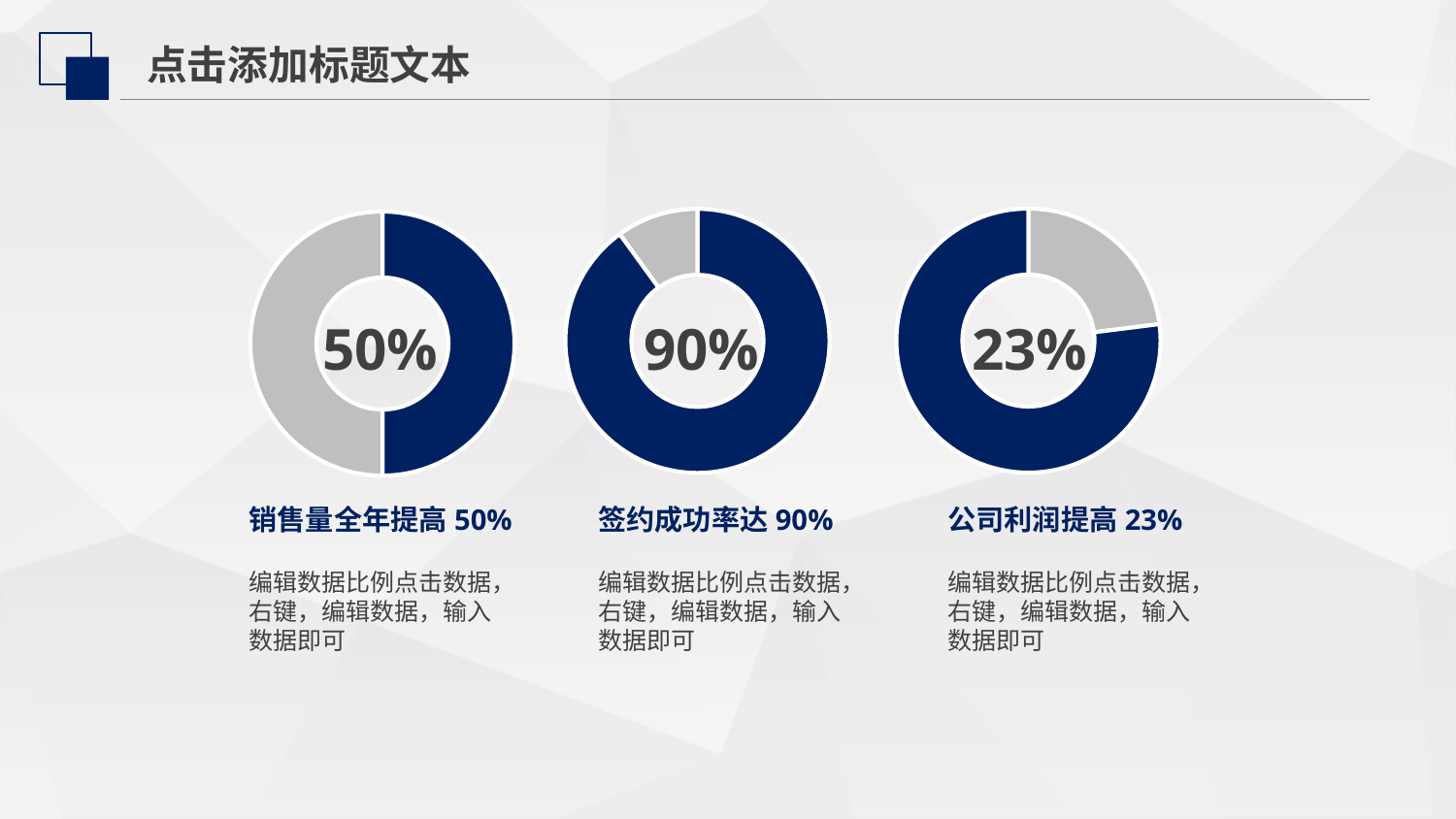
What percentage does the caption under the left donut chart say sales volume increased by over the year? 50% What colour is the filled (highlighted) portion of each donut chart? dark blue What kind of chart is used to show the 90% value? donut chart What value is shown in the center of the middle donut chart? 90% What value is shown in the center of the left donut chart? 50% Which of the three donut charts shows the lowest percentage? the right chart (23%) What is the difference between the percentage in the middle donut chart and the percentage in the right donut chart? 67% What value is shown in the center of the right donut chart? 23% How many donut charts are on the slide? 3 Is the percentage in the left donut chart larger or smaller than the percentage in the middle donut chart? smaller Which of the three donut charts shows the highest percentage? the middle chart (90%) What is the difference between the percentage in the left donut chart and the percentage in the right donut chart? 27%